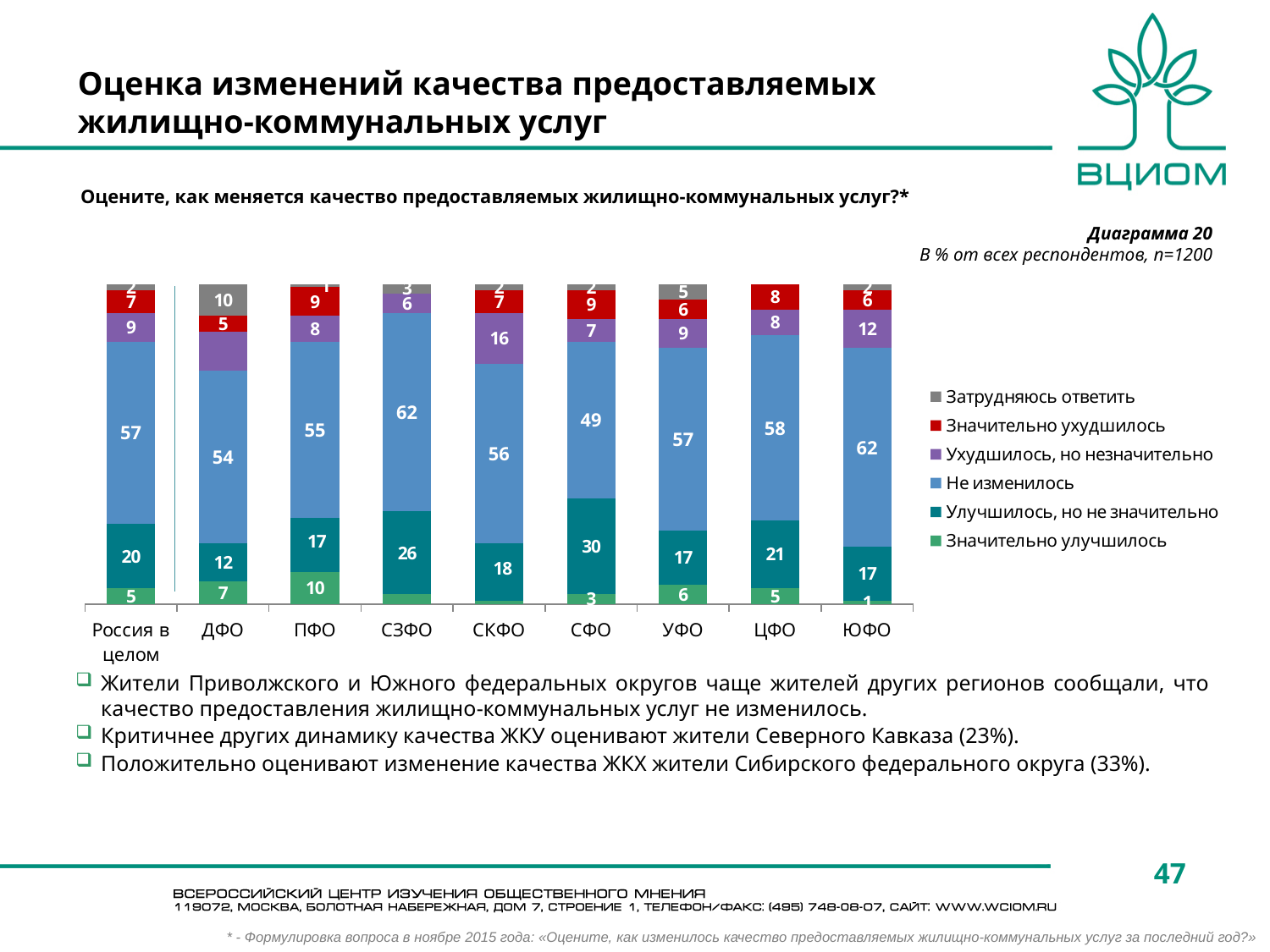
Which has the larger value for "Значительно улучшилось": ПФО or ДФО? ПФО Which region has the lowest value for "Не изменилось"? СФО What is the value of "Затрудняюсь ответить" for ДФО? 10 What is the value of "Улучшилось, но не значительно" for СФО? 30 How many categories (regions) are shown along the x axis of the chart? 9 What is the difference between the "Не изменилось" values for ЮФО and СФО? 13 What sample size (n) is stated above the chart? n=1200 What is the value of "Не изменилось" for "Россия в целом"? 57 What kind of chart is shown on the slide? Stacked bar chart How many series does the chart legend list? 6 Which region has the highest value for "Улучшилось, но не значительно"? СФО What is the value of "Ухудшилось, но незначительно" for СКФО? 16